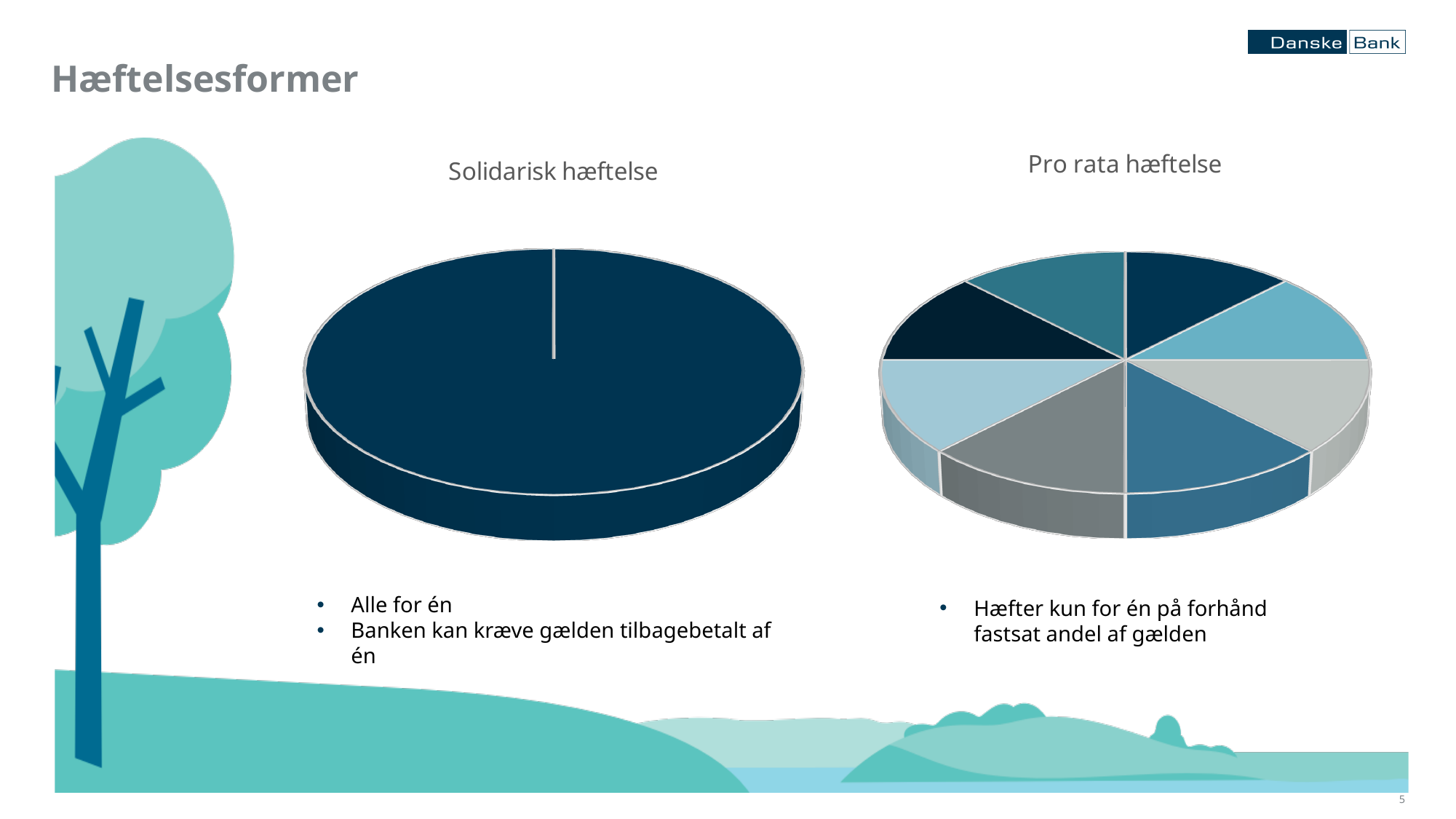
How many charts are shown on the slide? 2 In the "Solidarisk hæftelse" chart, how many slices does the pie have? 1 What kind of chart is shown under the title "Pro rata hæftelse"? Pie chart What is the title of the chart on the right side of the slide? Pro rata hæftelse Which chart has more slices, "Solidarisk hæftelse" or "Pro rata hæftelse"? Pro rata hæftelse In the "Pro rata hæftelse" chart, how many slices does the pie have? 8 What kind of chart is shown under the title "Solidarisk hæftelse"? Pie chart What is the title of the chart on the left side of the slide? Solidarisk hæftelse